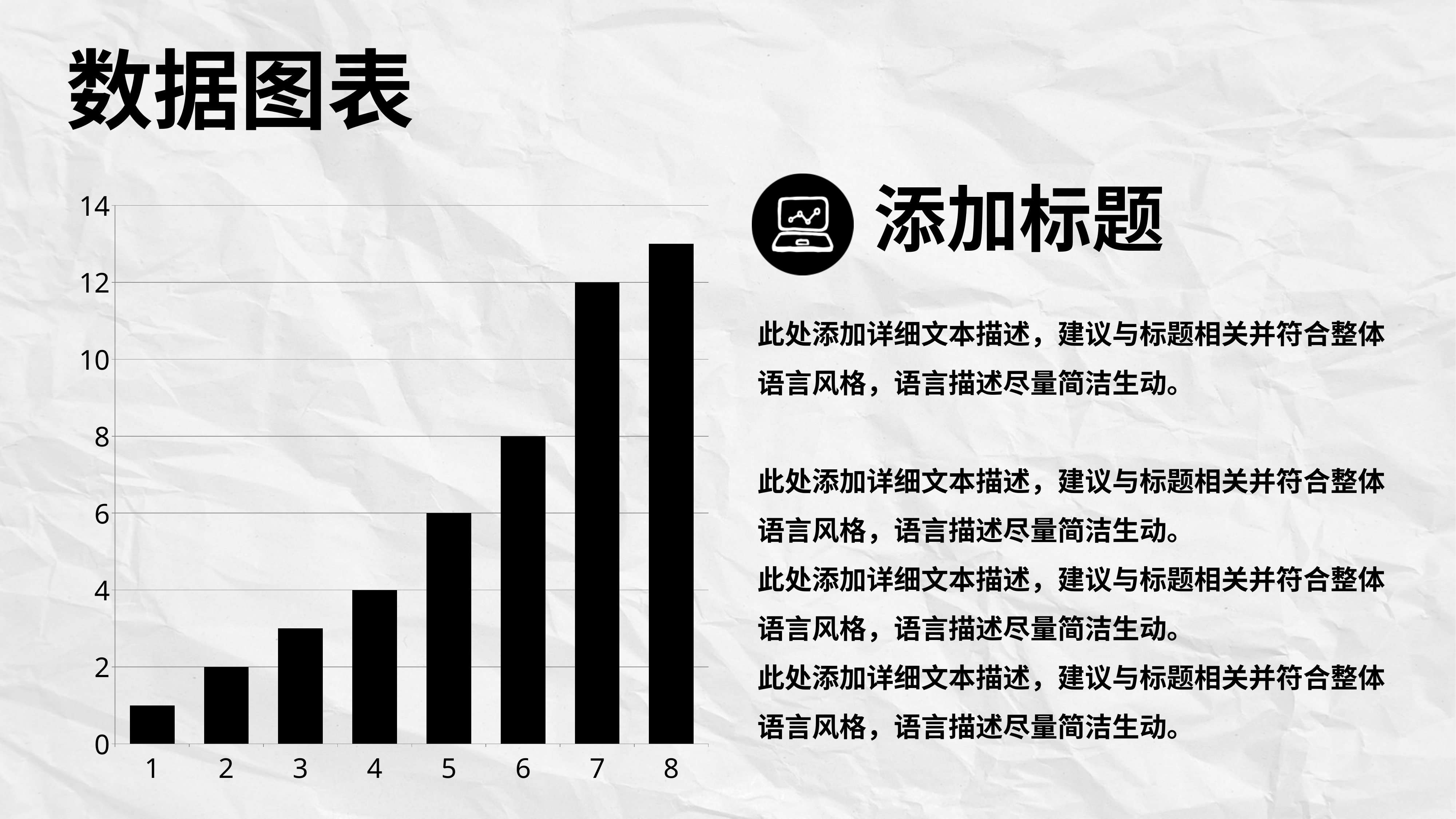
What type of chart is shown on the slide? bar chart Which category has the lowest bar? 1 Is the value for category 8 greater or less than 12? greater What is the value for category 2? 2 Which category has the highest bar? 8 What is the difference between the values for category 7 and category 5? 6 What is the value for category 6? 8 What is the highest value shown on the y axis of the chart? 14 Do the bar values rise or fall from category 1 to category 8? rise What is the value for category 7? 12 What is the value for category 4? 4 How many categories are shown on the x axis of the chart? 8